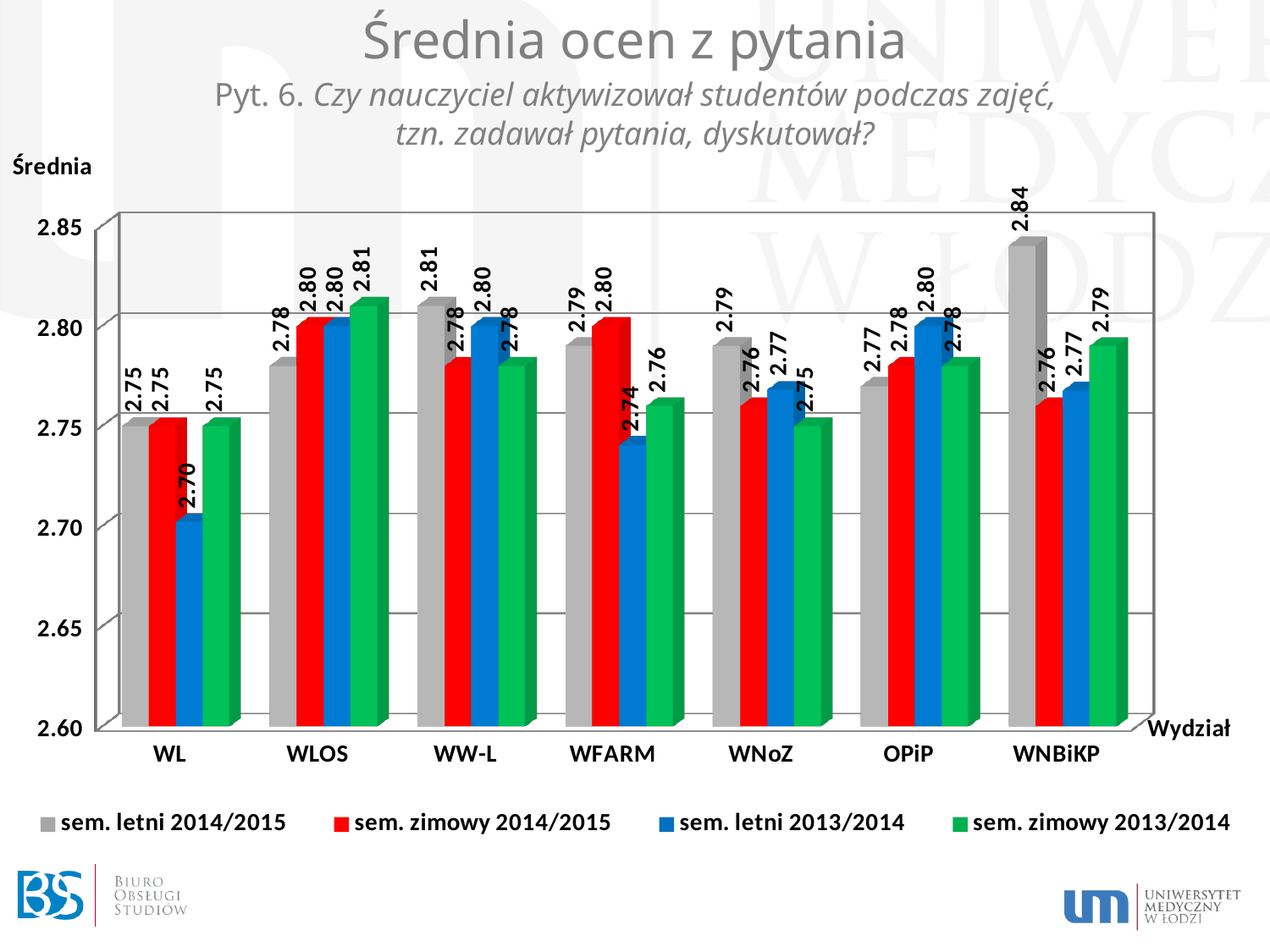
Which faculty has the lowest value in sem. letni 2013/2014? WL What is the value for WFARM in sem. letni 2013/2014? 2.74 How many faculties (categories) are shown on the x axis? 7 How many series does the legend list? 4 Is the value for WL in sem. letni 2013/2014 greater or less than 2.75? less What type of chart is shown on the slide? bar chart What is the value for WL in sem. letni 2013/2014? 2.70 What is the difference between the sem. letni 2014/2015 value for WNBiKP and its sem. zimowy 2014/2015 value? 0.08 Which series is shown in green in the legend? sem. zimowy 2013/2014 Which is larger for WW-L: sem. letni 2014/2015 or sem. zimowy 2014/2015? sem. letni 2014/2015 Which faculty has the highest value in sem. letni 2014/2015? WNBiKP What is the value for WNBiKP in sem. letni 2014/2015? 2.84